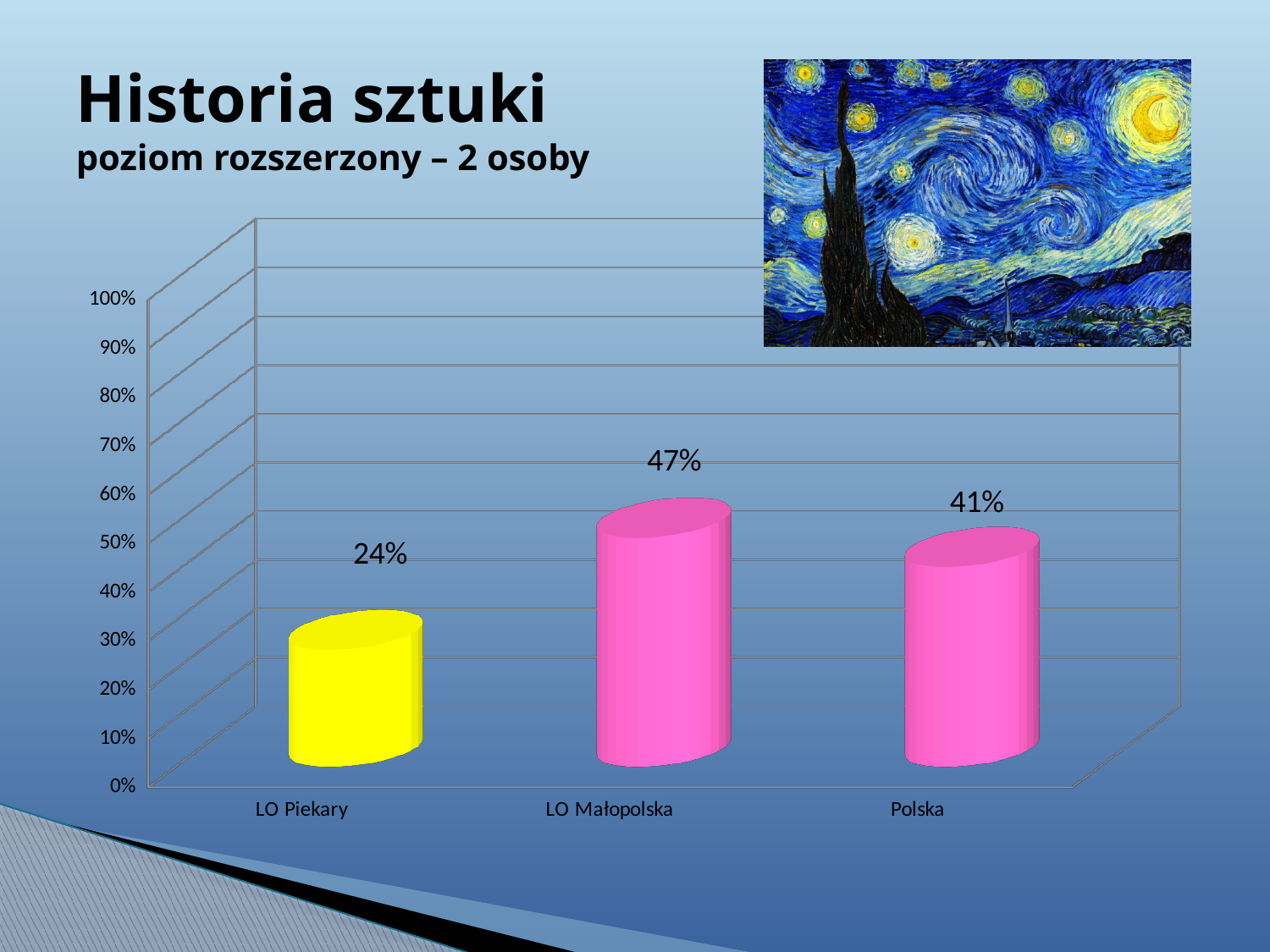
What is the value for Polska? 41% Which category has the lowest value? LO Piekary How many categories are shown on the chart? 3 What is the difference between the values for LO Małopolska and LO Piekary? 23% What is the value for LO Piekary? 24% What is the value for LO Małopolska? 47% What is the difference between the values for LO Małopolska and Polska? 6% Is the value for LO Piekary greater or less than 30%? less Which is larger, the value for Polska or the value for LO Piekary? Polska What colour is the bar for LO Piekary? yellow Which category has the highest value? LO Małopolska What kind of chart is shown on the slide? bar chart